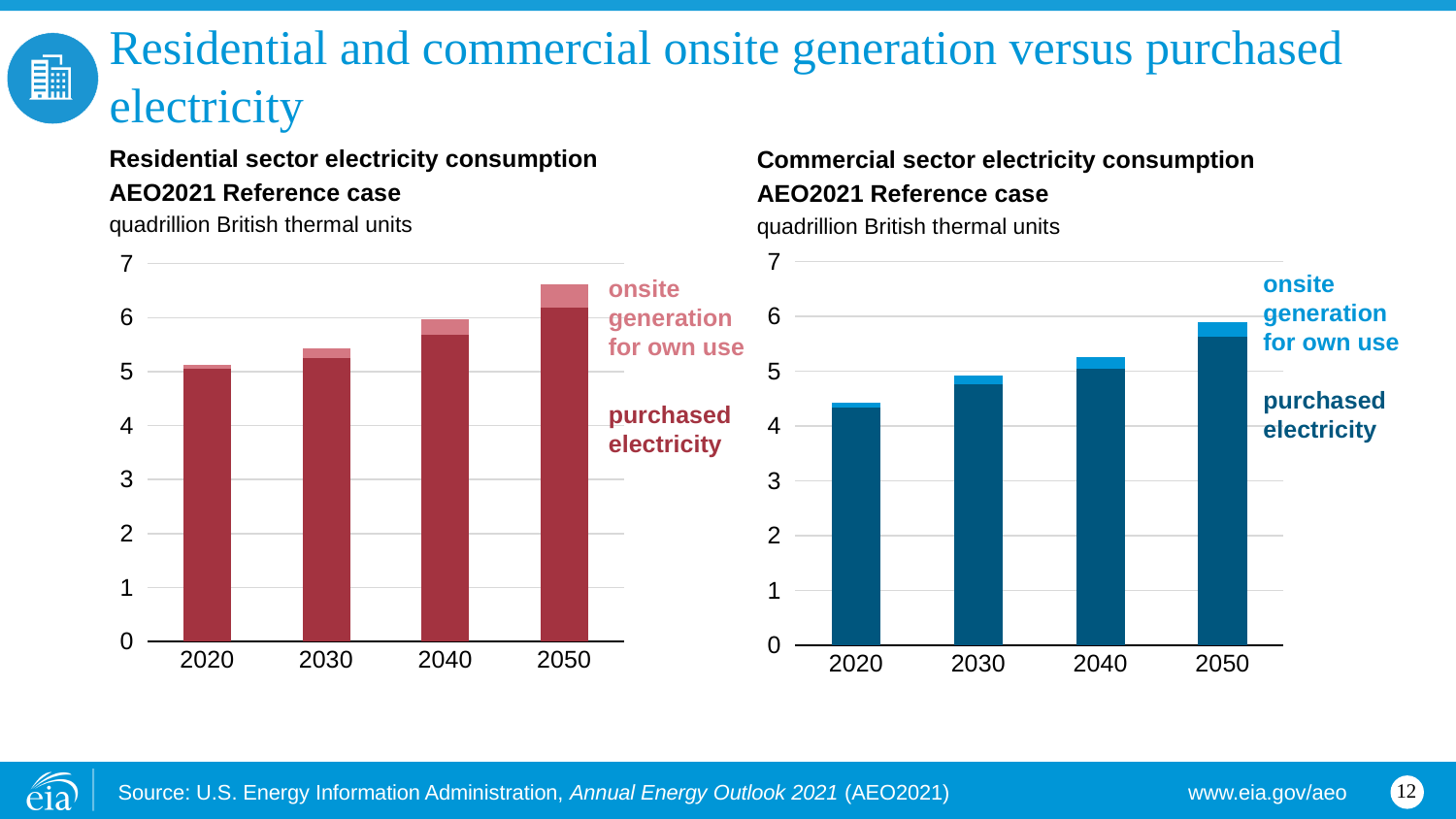
What kind of chart is the Residential sector electricity consumption chart? stacked bar chart Which is larger in the Residential sector electricity consumption chart: the total bar for 2020 or the total bar for 2050? 2050 In the Residential sector electricity consumption chart, which year has the tallest bar? 2050 How many years are shown on the x axis of the Commercial sector electricity consumption chart? 4 In the Commercial sector electricity consumption chart, which year has the shortest bar? 2020 What unit is used on the y axis of both charts? quadrillion British thermal units In the Commercial sector electricity consumption chart, is the total bar for 2020 greater or less than 5? less In the Commercial sector electricity consumption chart, do total bar heights rise or fall from 2020 to 2050? rise In the Residential sector electricity consumption chart, is the total bar for 2050 greater or less than 6? greater How many series are shown in the Residential sector electricity consumption chart? 2 In the Commercial sector electricity consumption chart, is the total bar for 2040 greater or less than 5? greater